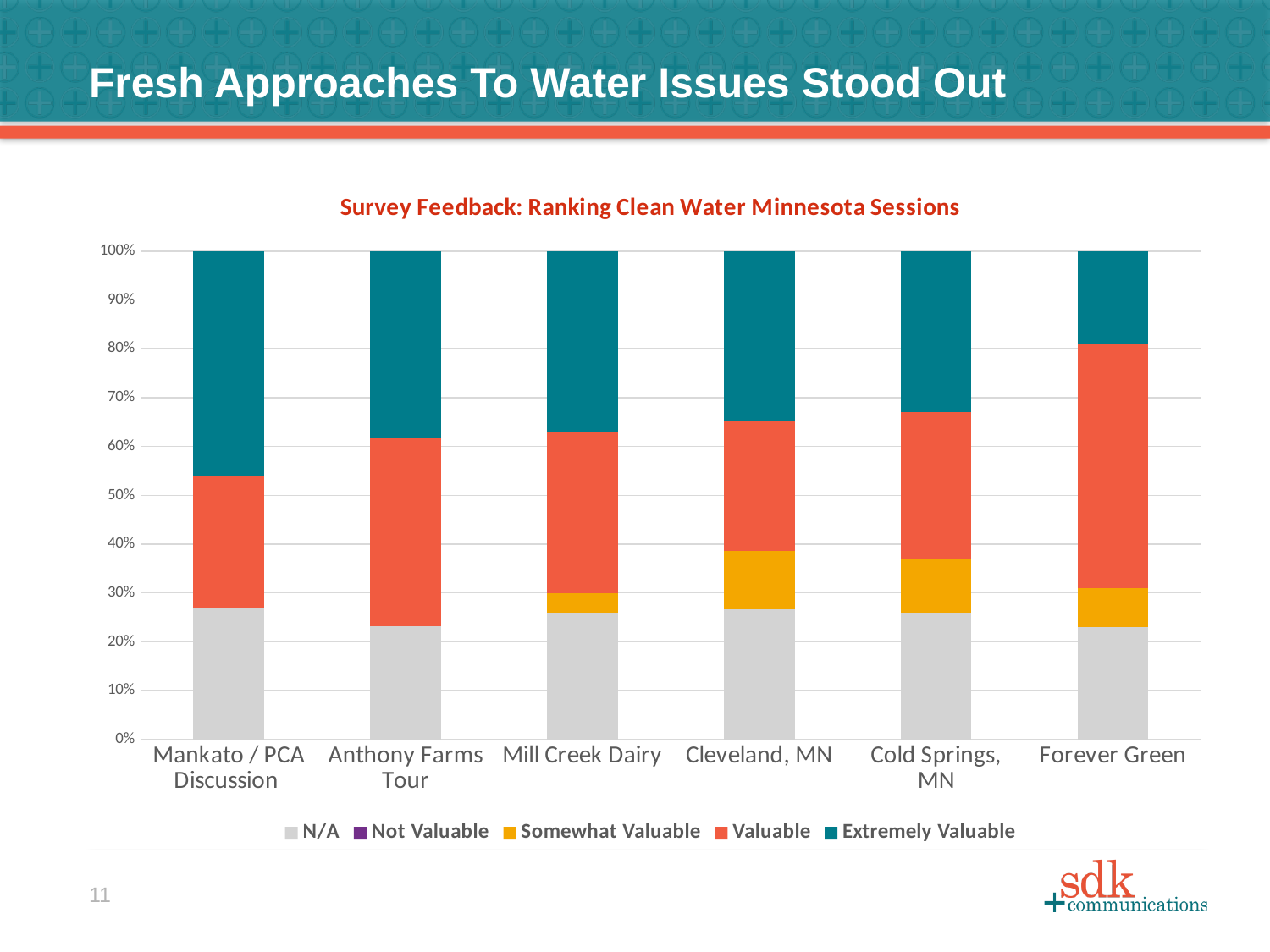
How many series does the chart legend list? 5 What is the title of the chart? Survey Feedback: Ranking Clean Water Minnesota Sessions How many sessions (categories) are shown on the x axis of the chart? 6 Which is larger, the Extremely Valuable share for Mankato / PCA Discussion or for Cold Springs, MN? Mankato / PCA Discussion Which session has the smallest Extremely Valuable share? Forever Green What kind of chart is shown on the slide? Stacked bar chart Is the Extremely Valuable share for Forever Green greater or less than 30%? less Which session has the largest Extremely Valuable share? Mankato / PCA Discussion Which session has the largest Valuable share? Forever Green Is the Valuable share for Forever Green greater or less than 40%? greater Is the Extremely Valuable share for Mankato / PCA Discussion greater or less than 40%? greater Which legend series has no visible segment in any of the bars? Not Valuable